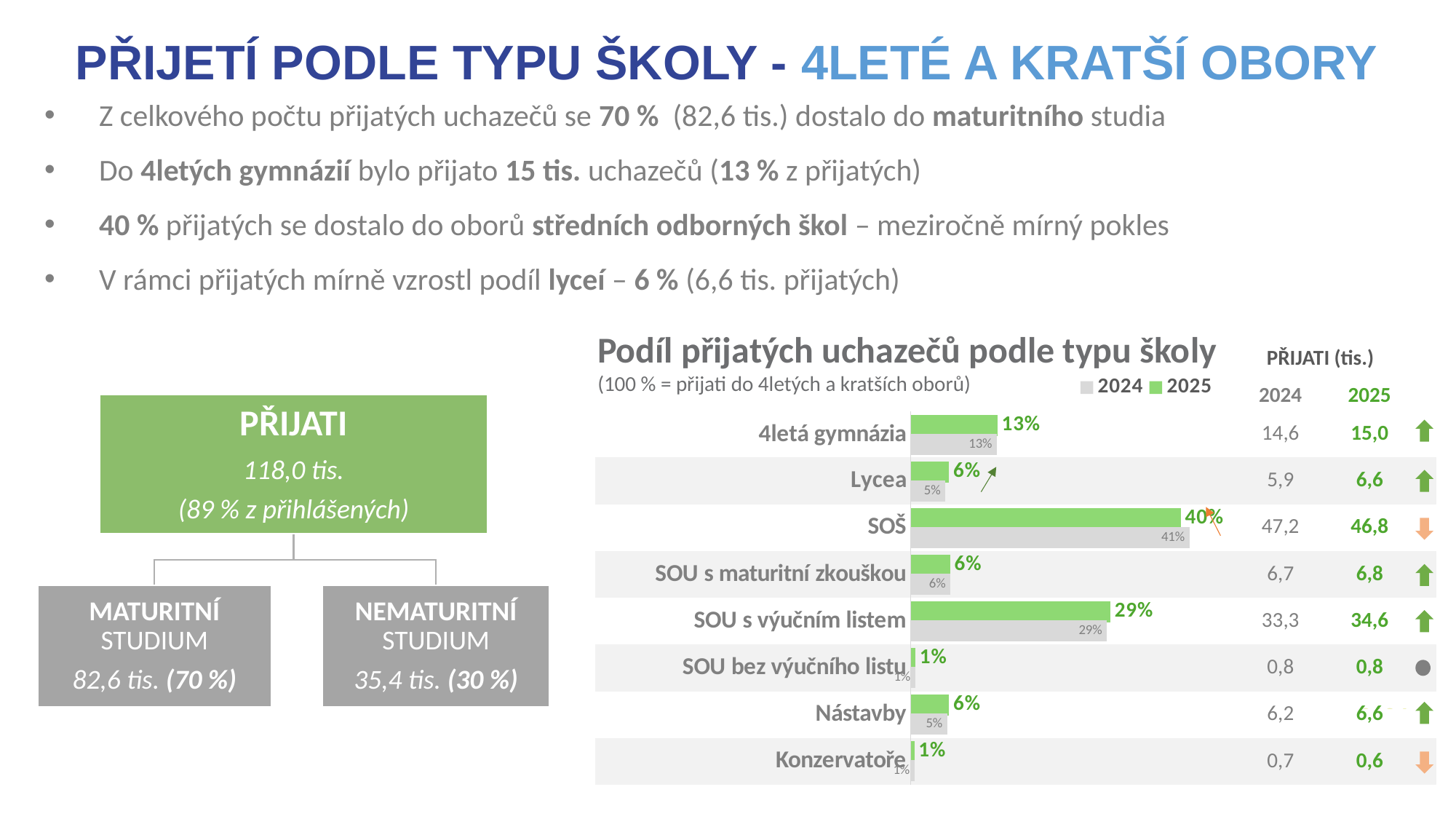
How many series does the legend of the chart 'Podíl přijatých uchazečů podle typu školy' list? 2 In the chart 'Podíl přijatých uchazečů podle typu školy', what is the 2024 value for Lycea? 5% In the chart 'Podíl přijatých uchazečů podle typu školy', what is the 2025 value for SOŠ? 40% In the chart 'Podíl přijatých uchazečů podle typu školy', what is the difference between the 2024 and 2025 values for Nástavby? 1% In the chart 'Podíl přijatých uchazečů podle typu školy', which is larger: the 2025 value for 4letá gymnázia or the 2025 value for Lycea? 4letá gymnázia How many school-type categories are shown in the chart 'Podíl přijatých uchazečů podle typu školy'? 8 In the chart 'Podíl přijatých uchazečů podle typu školy', what is the 2025 value for SOU s výučním listem? 29% In the chart 'Podíl přijatých uchazečů podle typu školy', which colour represents the 2025 series? green In the chart 'Podíl přijatých uchazečů podle typu školy', what is the difference between the 2025 values for SOŠ and SOU s výučním listem? 11% In the chart 'Podíl přijatých uchazečů podle typu školy', which category has the highest 2025 share? SOŠ What type of chart is 'Podíl přijatých uchazečů podle typu školy'? bar chart In the chart 'Podíl přijatých uchazečů podle typu školy', what is the 2024 value for SOŠ? 41%